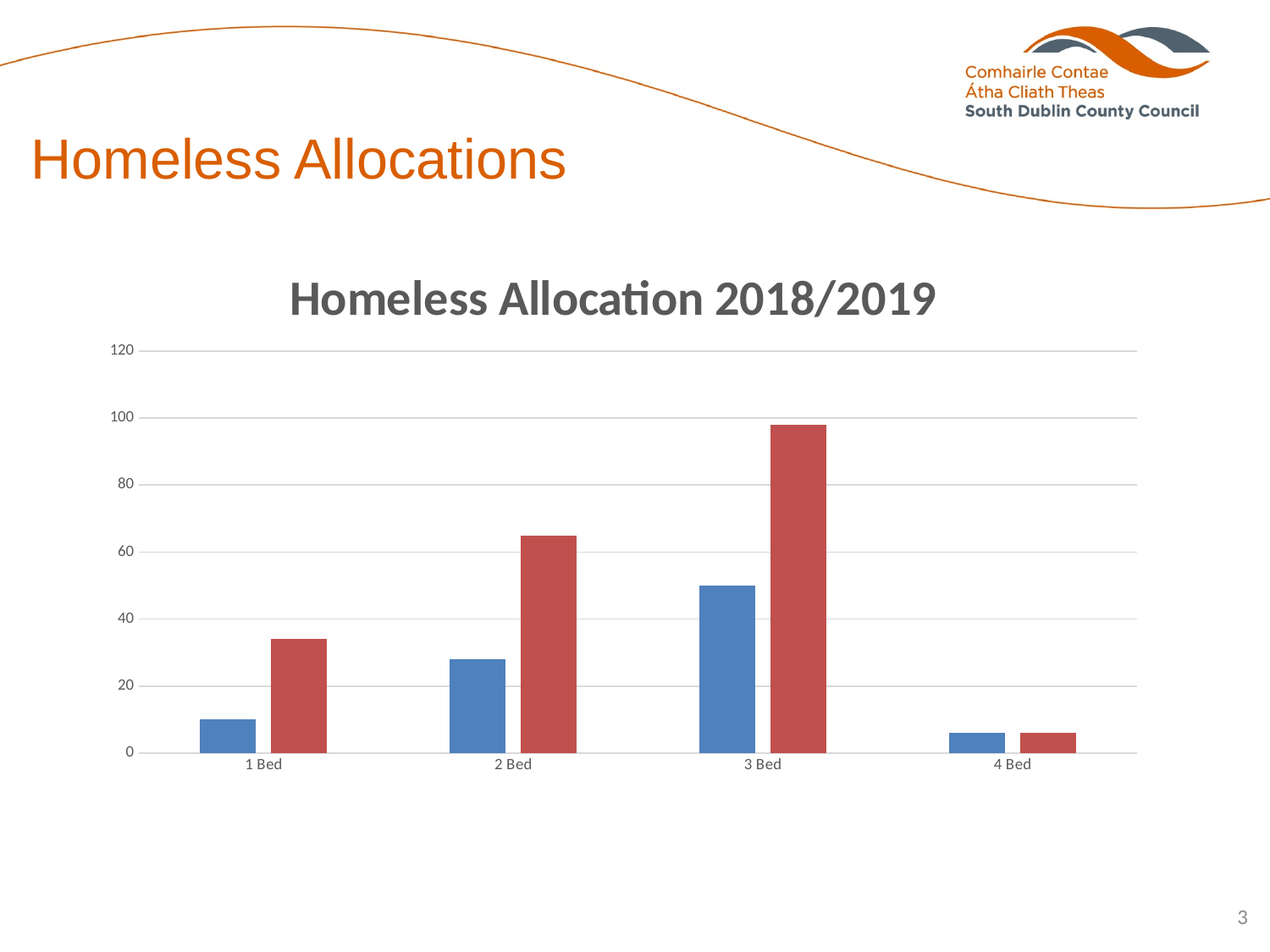
How many bars are plotted for each bed category? 2 Is the value of the red bar for 3 Bed greater or less than 80? greater What is the title of the chart? Homeless Allocation 2018/2019 Do the red bars rise or fall from 1 Bed to 3 Bed? Rise Is the value of the red bar for 2 Bed greater or less than 60? greater How many categories are shown on the x axis of the chart? 4 For 3 Bed, which bar is larger, the blue bar or the red bar? The red bar Which category has the lowest values for both bars? 4 Bed What type of chart is shown on the slide? Bar chart Is the value of the blue bar for 1 Bed greater or less than 20? less Which category has the tallest bar in the chart? 3 Bed